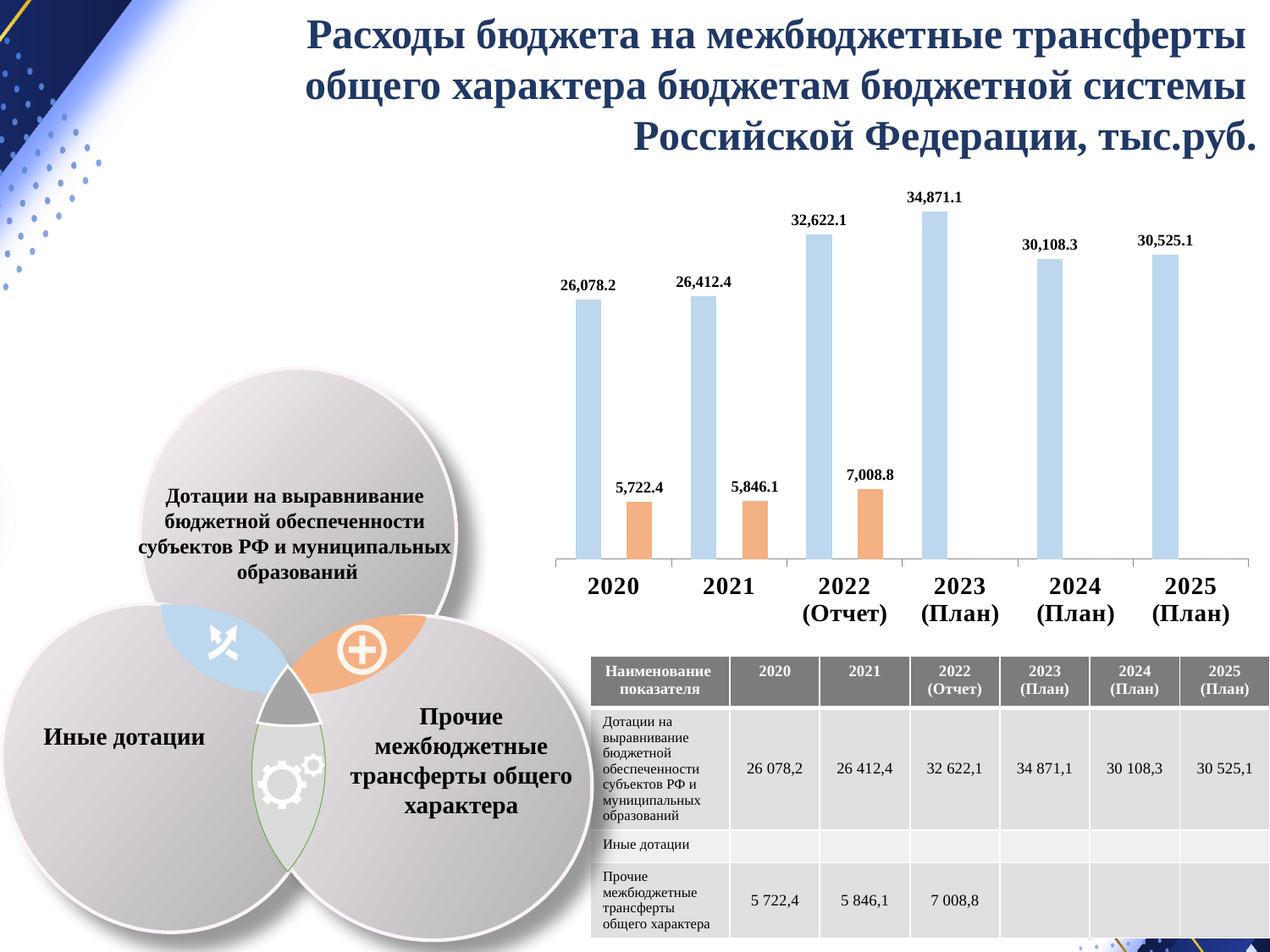
Which year has the lowest blue bar? 2020 What is the difference between the orange bar values for 2022 (Отчет) and 2021? 1,162.7 What is the difference between the blue bar values for 2023 (План) and 2022 (Отчет)? 2,249.0 How many years are shown on the x axis of the chart? 6 What is the value of the blue bar for 2023 (План)? 34,871.1 Which year has the highest blue bar? 2023 (План) What type of chart is shown on the slide? Bar chart What is the value of the orange bar for 2022 (Отчет)? 7,008.8 Which is larger, the blue bar for 2024 (План) or the blue bar for 2025 (План)? 2025 (План) What is the value of the blue bar for 2020? 26,078.2 Which year has the lowest orange bar? 2020 Do the blue bars rise or fall from 2020 to 2023 (План)? Rise